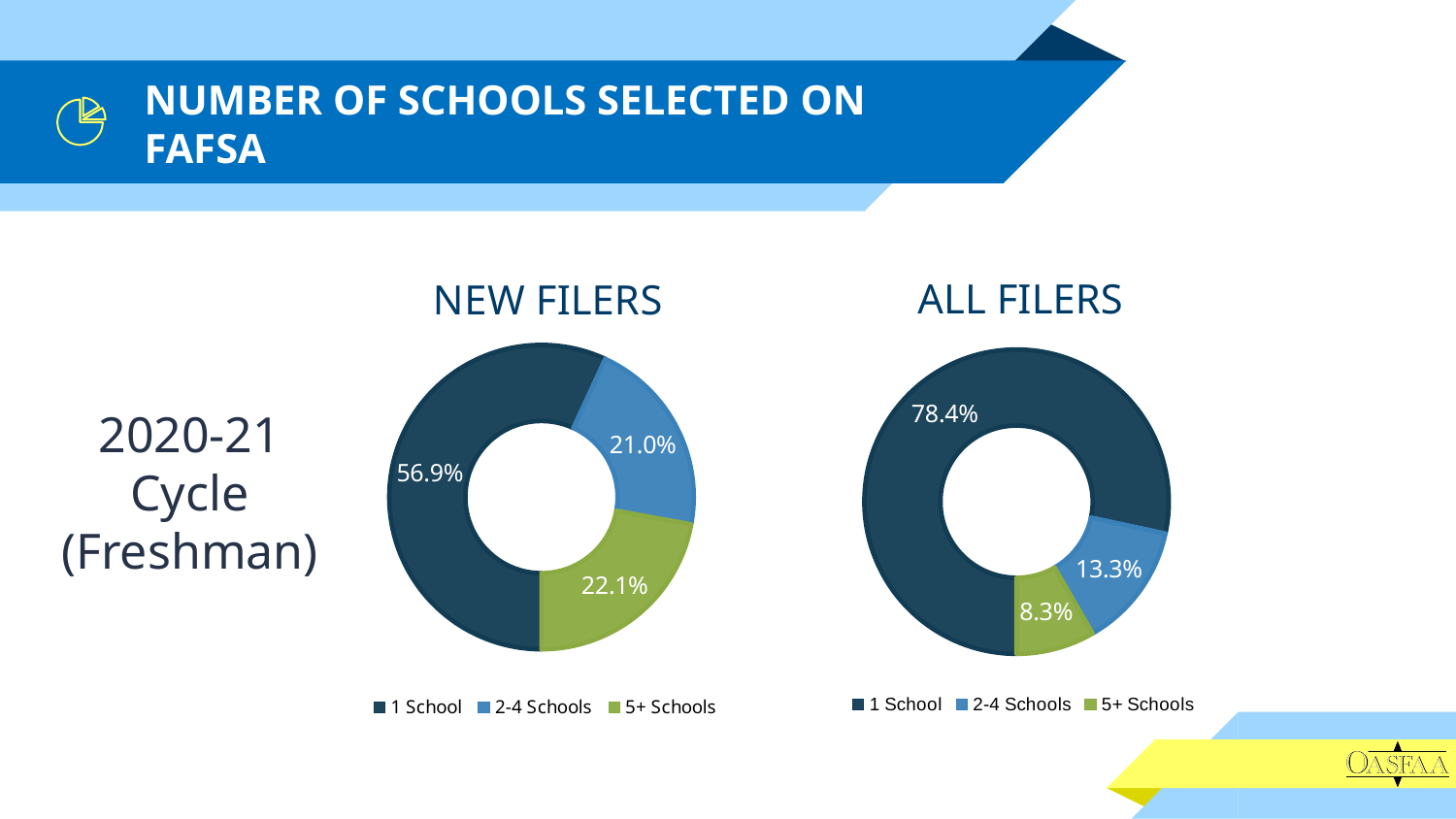
What is the difference between the 1 School share in the ALL FILERS chart and the 1 School share in the NEW FILERS chart? 21.5% How many entries does the legend of the NEW FILERS chart list? 3 In the ALL FILERS chart, which category has the smallest share? 5+ Schools What type of chart is the NEW FILERS chart? Donut chart What is the title of the chart on the right side of the slide? ALL FILERS In the NEW FILERS chart, which category has the largest share? 1 School How many categories does the ALL FILERS chart show? 3 In the ALL FILERS chart, what percentage of filers selected 5+ Schools? 8.3% In the NEW FILERS chart, what percentage of filers selected 1 School? 56.9% In the NEW FILERS chart, which is larger: the share for 2-4 Schools or the share for 5+ Schools? 5+ Schools In the NEW FILERS chart, which category has the smallest share? 2-4 Schools In the ALL FILERS chart, what percentage of filers selected 2-4 Schools? 13.3%